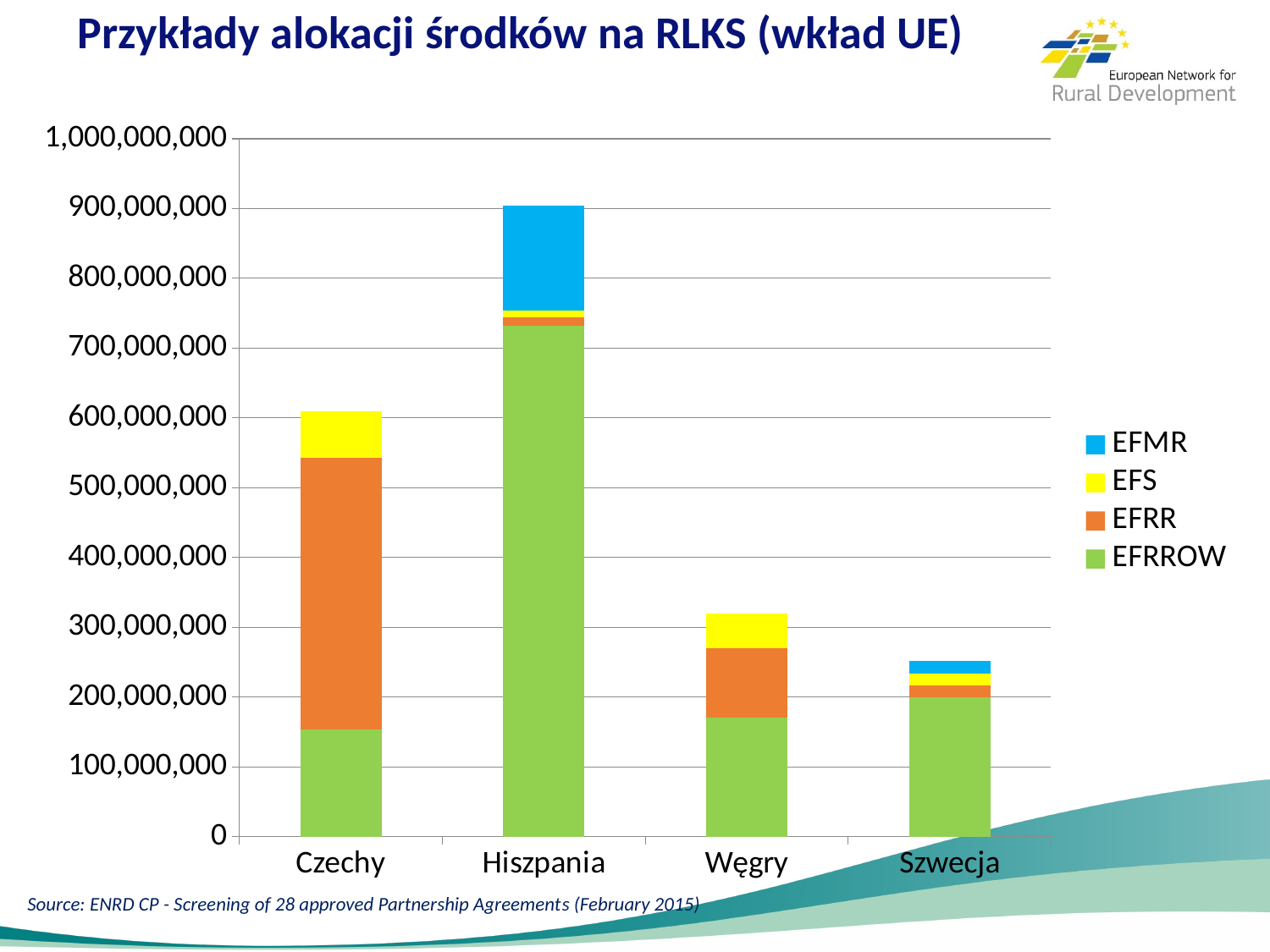
How many countries are shown on the x axis of the chart? 4 Is the total bar for Czechy greater or less than 500,000,000? greater Which country has the lowest total bar? Szwecja Which has a larger total bar, Czechy or Węgry? Czechy Which country has the highest total bar? Hiszpania What kind of chart is shown on the slide? Stacked bar chart Which country has the largest EFRR (orange) segment? Czechy Is the total bar for Hiszpania greater or less than 800,000,000? greater How many series does the legend list? 4 Is the total bar for Węgry greater or less than 400,000,000? less Which series appears at the bottom of each stacked bar? EFRROW